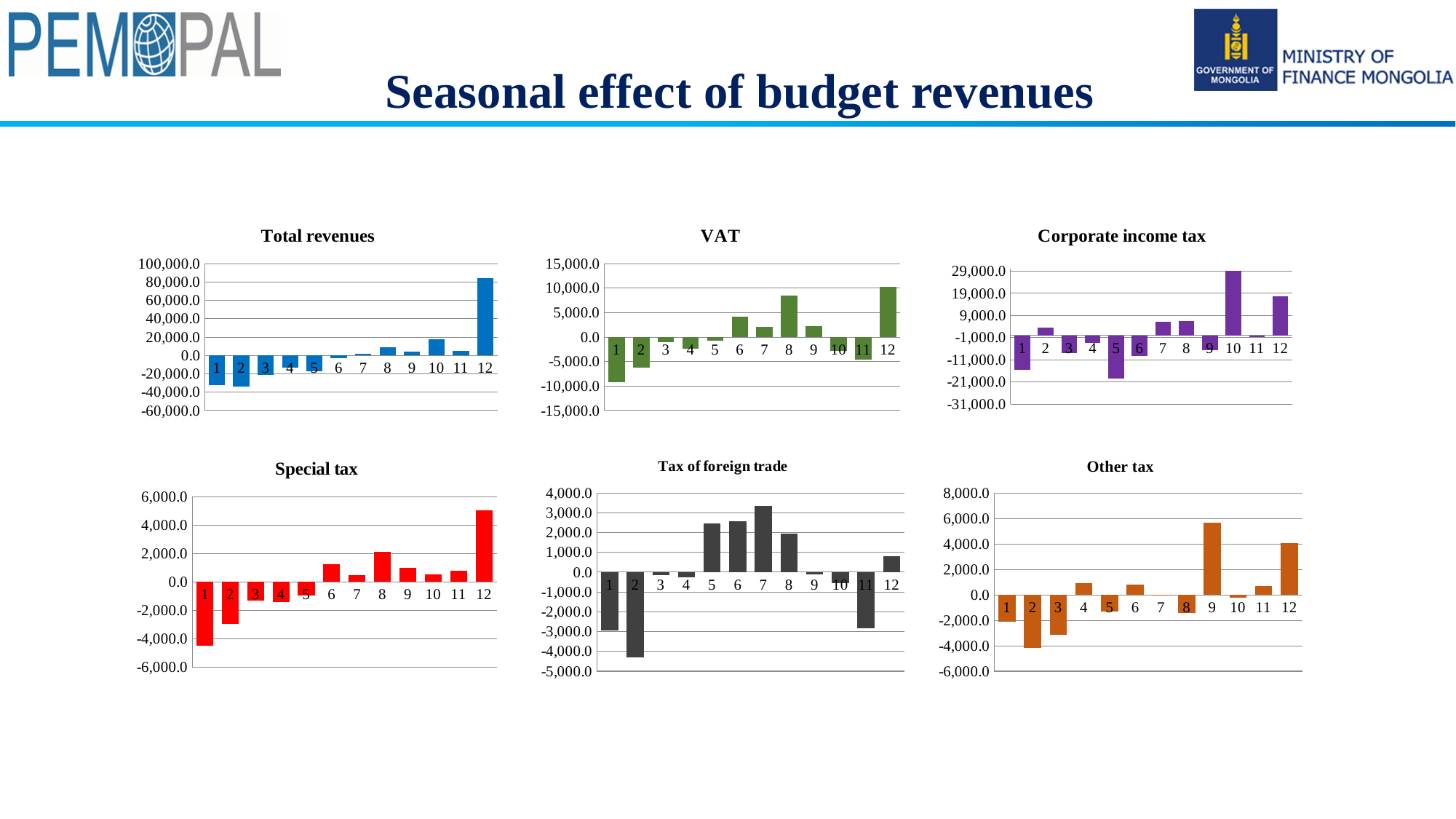
In the Tax of foreign trade chart, which month has the highest value? 7 What type of chart is the Total revenues chart? bar chart In the Total revenues chart, which month has the highest value? 12 In the VAT chart, which month has the highest value? 12 In the Corporate income tax chart, which month has the lowest value? 5 In the Special tax chart, is the value for month 12 greater or less than 4,000.0? greater In the VAT chart, which month has the lowest value? 1 In the Other tax chart, is the value for month 9 greater or less than 4,000.0? greater In the Tax of foreign trade chart, which month has the lowest value? 2 How many months (categories) are plotted in the Special tax chart? 12